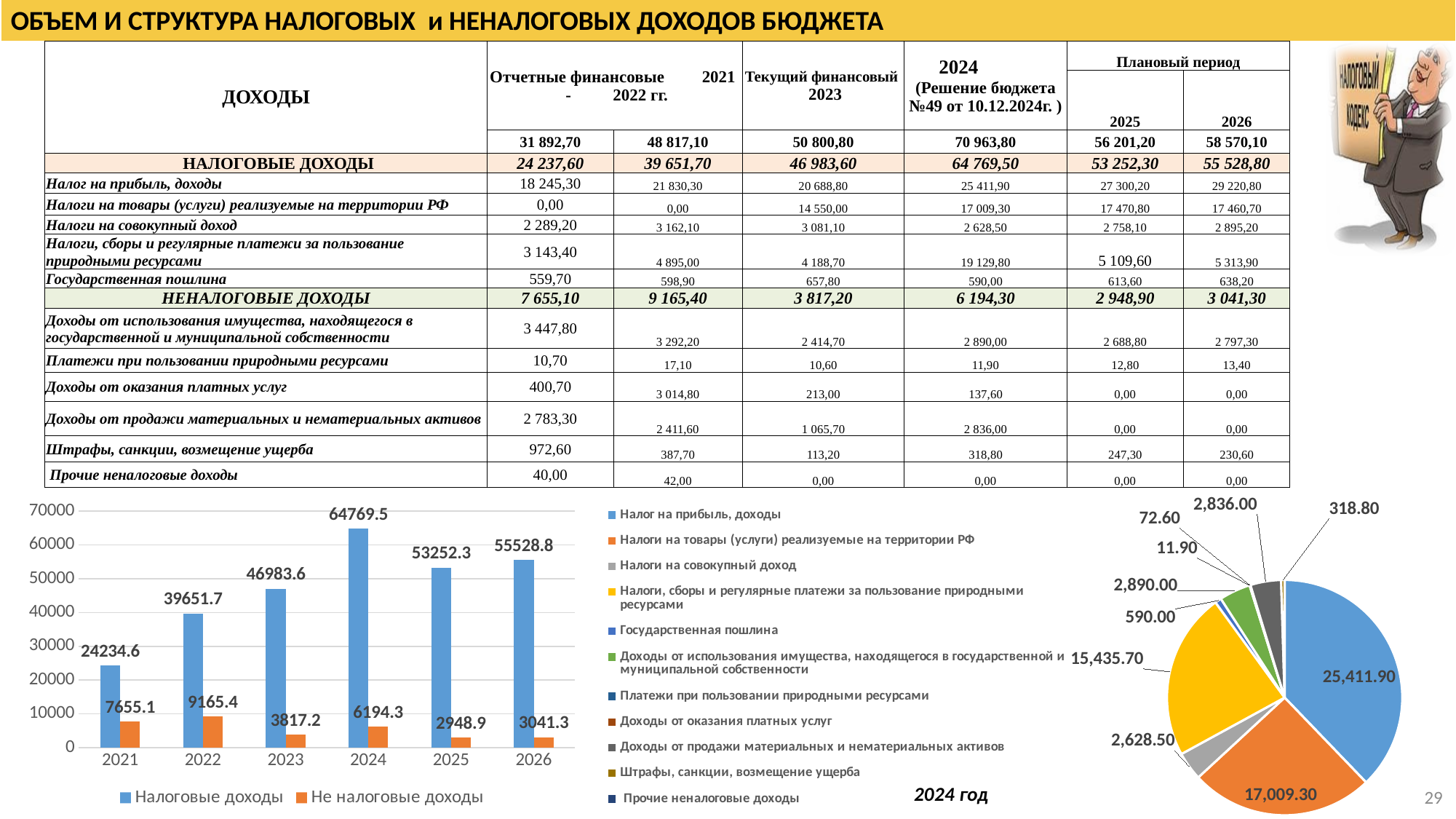
In the bar chart, which year has the lowest value for Не налоговые доходы? 2025 How many series does the legend of the bar chart list? 2 In the pie chart, what is the value of the orange slice (Налоги на товары (услуги) реализуемые на территории РФ)? 17,009.30 In the pie chart, what is the value of the largest slice? 25,411.90 In the bar chart, do the values for Налоговые доходы rise or fall from 2021 to 2024? rise In the bar chart, what is the difference between Налоговые доходы in 2026 and in 2025? 2276.5 In the bar chart, what is the value for Налоговые доходы in 2024? 64769.5 In the bar chart, which is larger: Не налоговые доходы in 2023 or in 2024? 2024 How many years are shown on the x axis of the bar chart? 6 What kind of chart is the chart in the bottom left of the slide? bar chart In the bar chart, what is the value for Не налоговые доходы in 2022? 9165.4 In the bar chart, which year has the highest value for Налоговые доходы? 2024